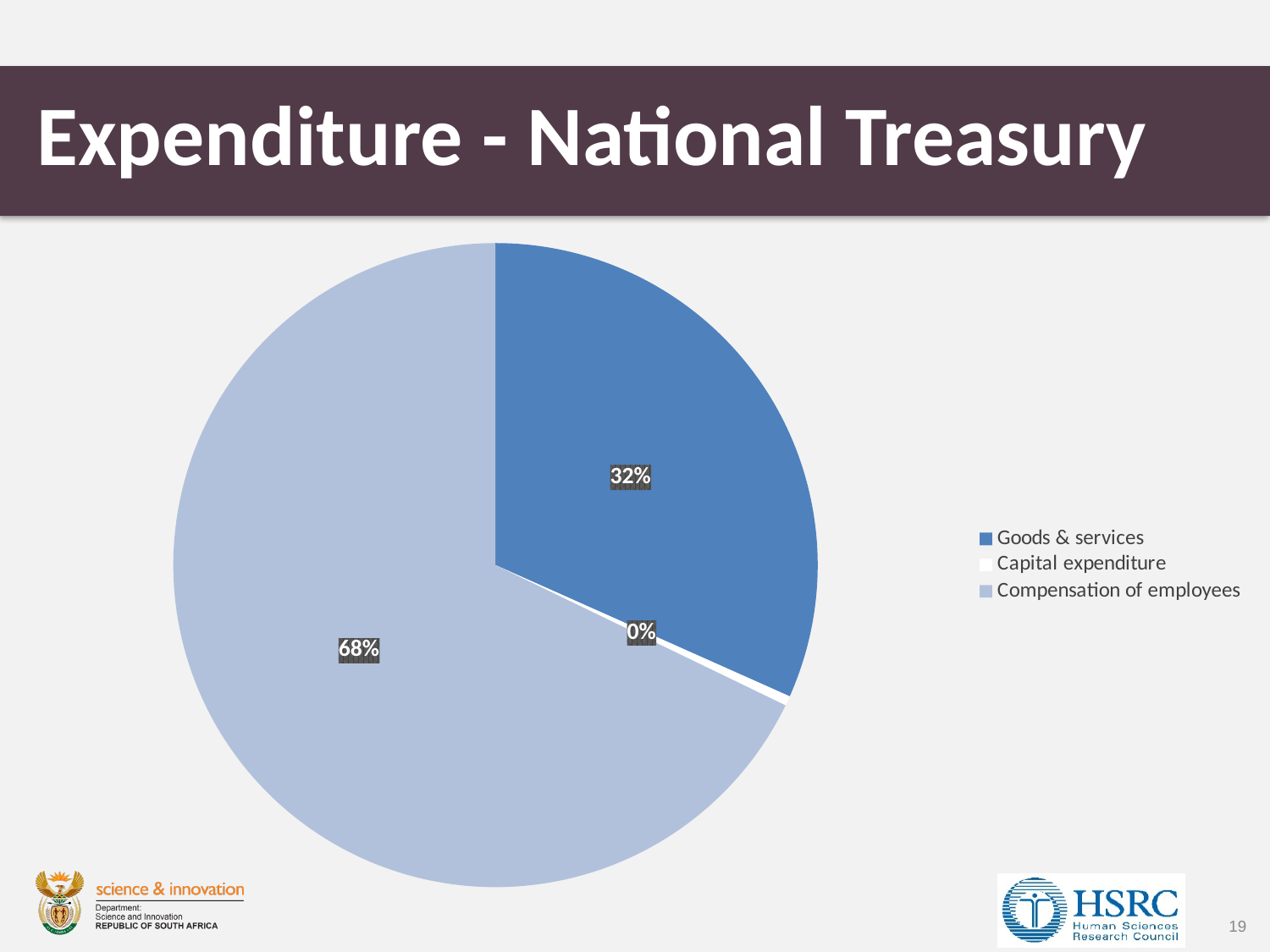
What is the difference in percentage points between Compensation of employees and Goods & services? 36 Which is larger, the share for Goods & services or the share for Compensation of employees? Compensation of employees What kind of chart is shown on the slide? Pie chart Is the share for Goods & services greater or less than 50%? less What share of the pie does Goods & services represent? 32% Which legend entry is shown in the darker blue colour? Goods & services Which category has the smallest slice of the pie? Capital expenditure What share of the pie does Capital expenditure represent? 0% Which category has the largest slice of the pie? Compensation of employees How many categories does the legend list? 3 What is the title of the slide containing the chart? Expenditure - National Treasury What share of the pie does Compensation of employees represent? 68%